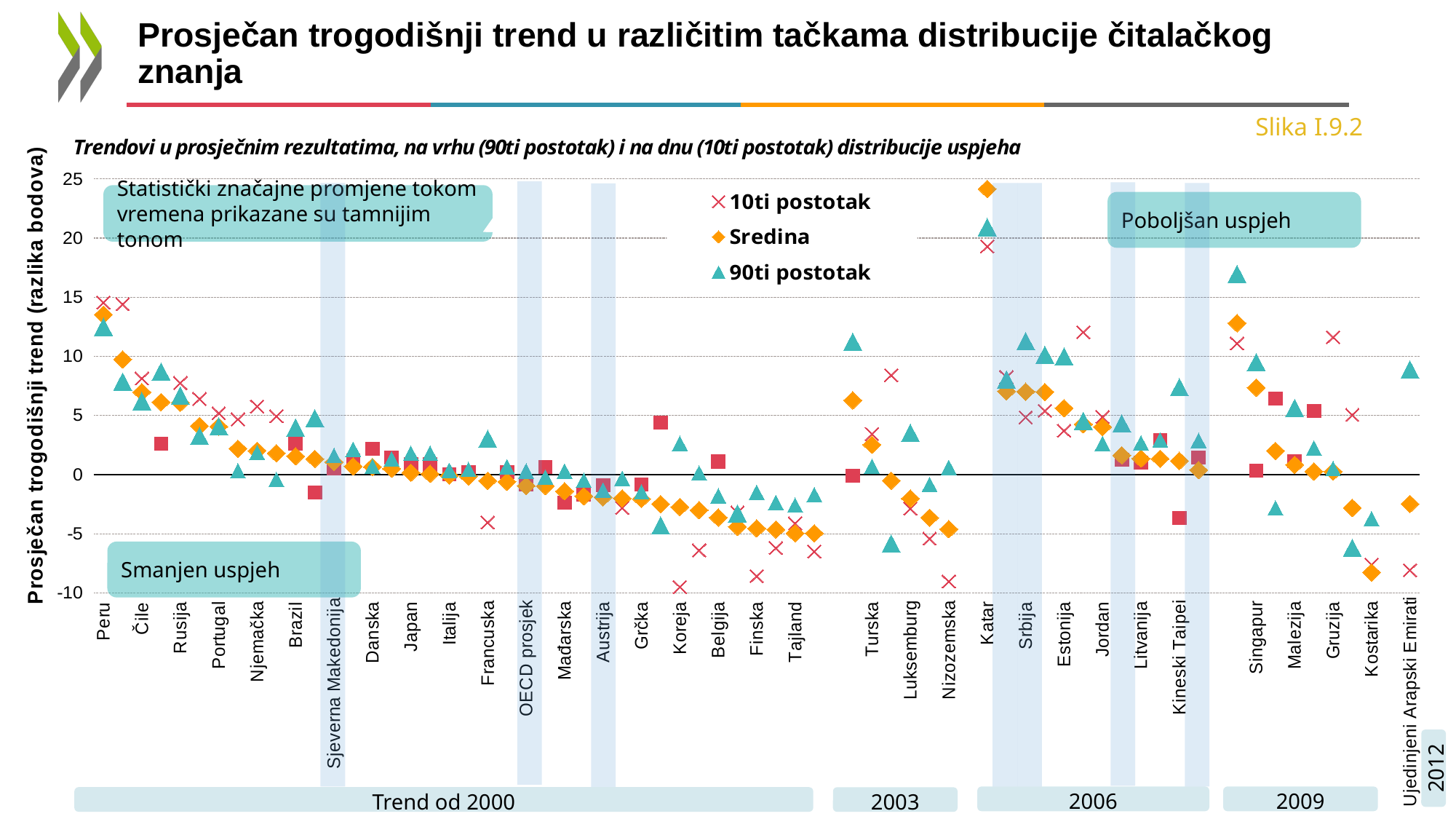
What is the figure number shown on the slide? Slika I.9.2 Is the 10ti postotak value for Nizozemska greater or less than -5? less Is the 10ti postotak value for Koreja greater or less than -5? less What kind of chart is shown on the slide? scatter chart Is the 90ti postotak value for Singapur greater or less than 15? less Which is larger, the Sredina value for Peru or for Čile? Peru How many series does the legend list? 3 Which category has the highest value for the Sredina series? Katar Which category has the highest value for the 90ti postotak series? Katar Which category has the lowest value for the Sredina series? Kostarika